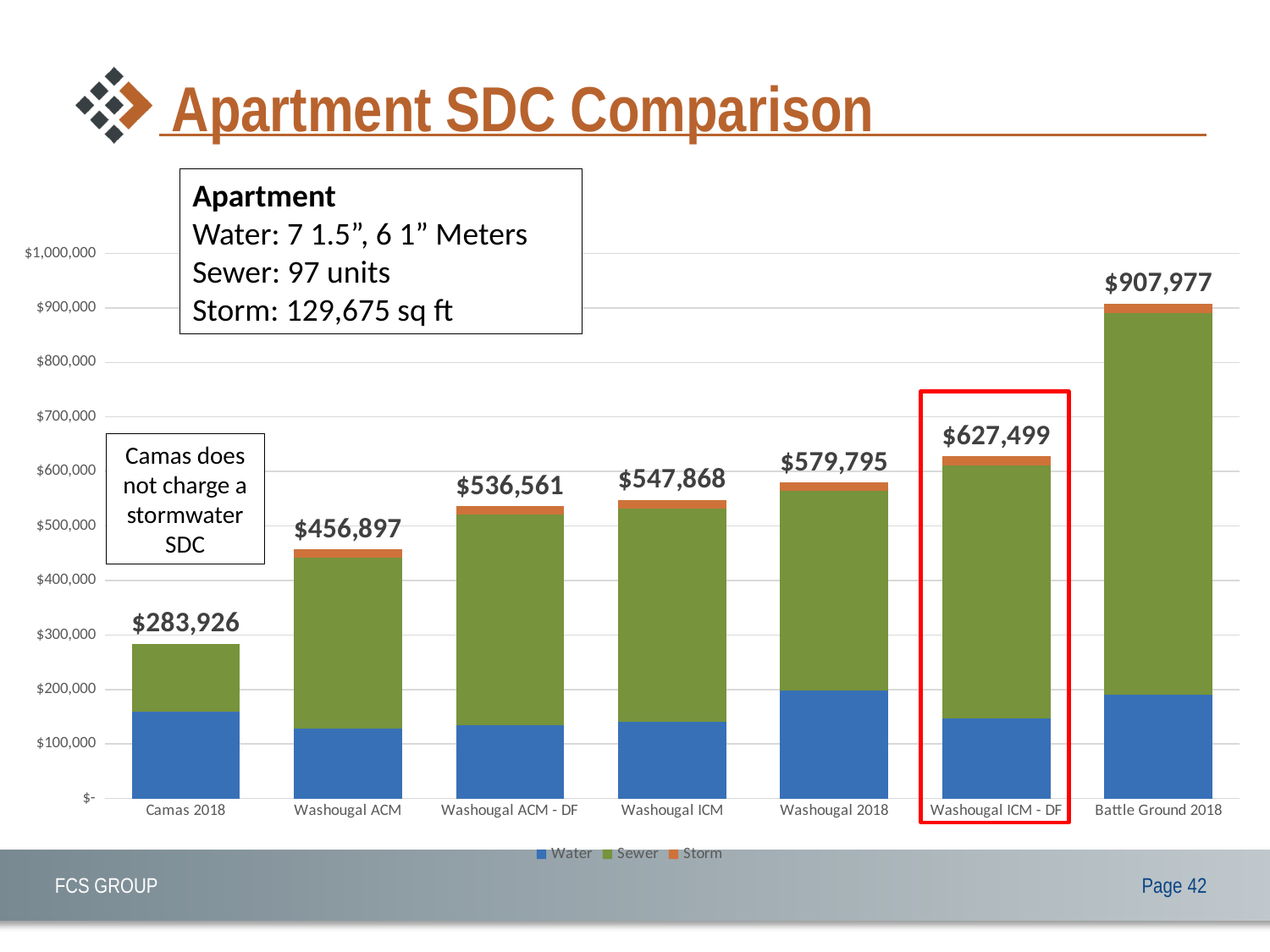
What is the total Apartment SDC shown for Washougal ICM - DF? $627,499 Is the Water value for Camas 2018 greater or less than $100,000? greater What kind of chart is shown on the slide? Stacked bar chart How many categories are shown on the x axis? 7 Which category has the lowest total Apartment SDC? Camas 2018 How many series does the legend list? 3 What is the total Apartment SDC shown for Battle Ground 2018? $907,977 What is the difference between the total for Washougal ICM - DF and the total for Washougal 2018? $47,704 Which is larger, the total for Washougal ACM or the total for Washougal 2018? Washougal 2018 What is the total Apartment SDC shown for Camas 2018? $283,926 What is the difference between the total for Battle Ground 2018 and the total for Camas 2018? $624,051 Which category has the highest total Apartment SDC? Battle Ground 2018